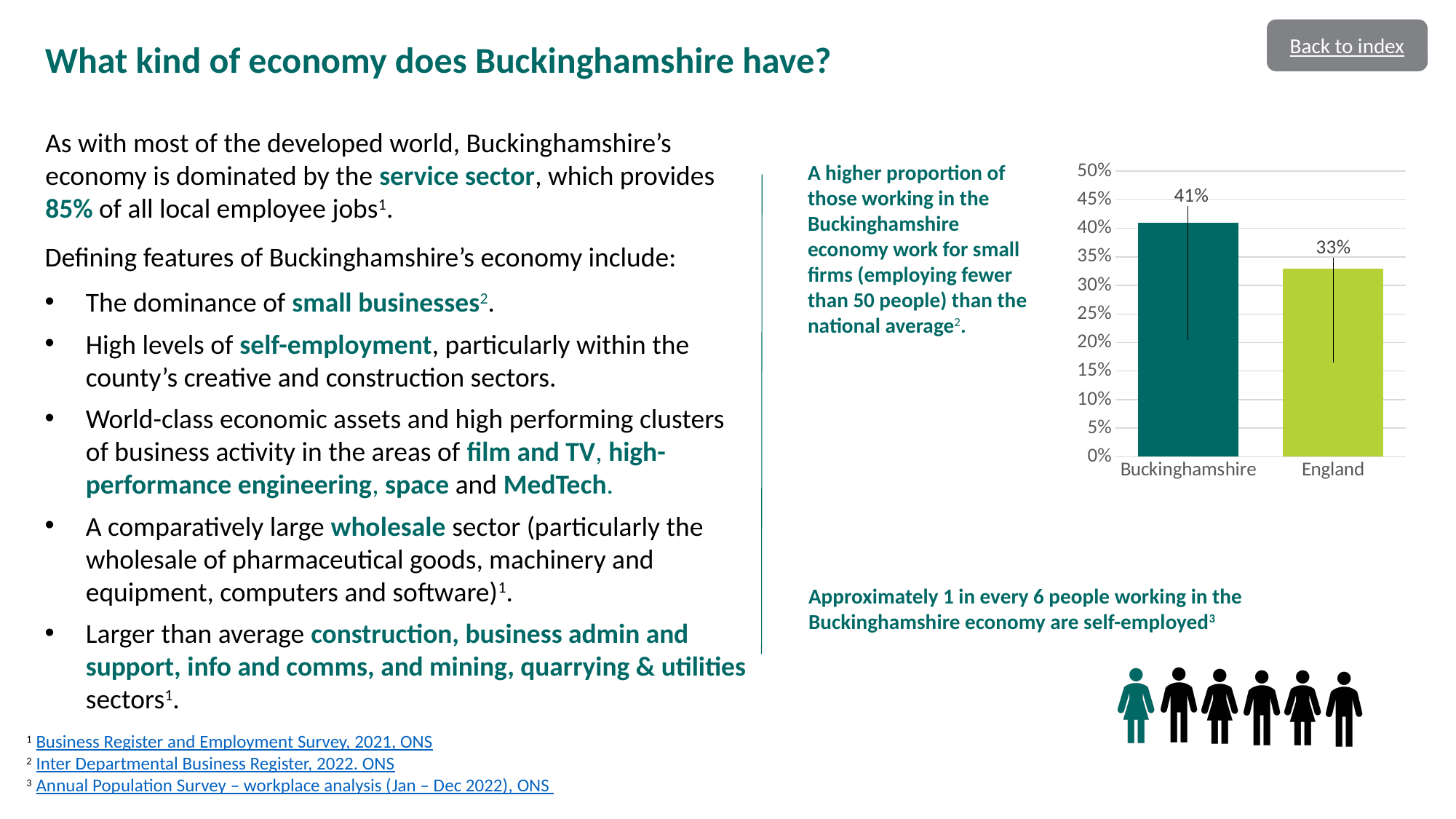
What is the highest value shown on the y axis of the bar chart? 50% What colour is the Buckinghamshire bar in the bar chart? Dark teal What is the value for Buckinghamshire in the bar chart? 41% How many categories are shown in the bar chart? 2 Is the value for England in the bar chart greater or less than 35%? less Which is larger in the bar chart, the value for Buckinghamshire or the value for England? Buckinghamshire Is the value for Buckinghamshire in the bar chart greater or less than 40%? greater Which category has the lowest value in the bar chart? England Which category has the highest value in the bar chart? Buckinghamshire What is the difference between the Buckinghamshire and England values in the bar chart? 8% What is the value for England in the bar chart? 33% What kind of chart is shown on the slide? Bar chart